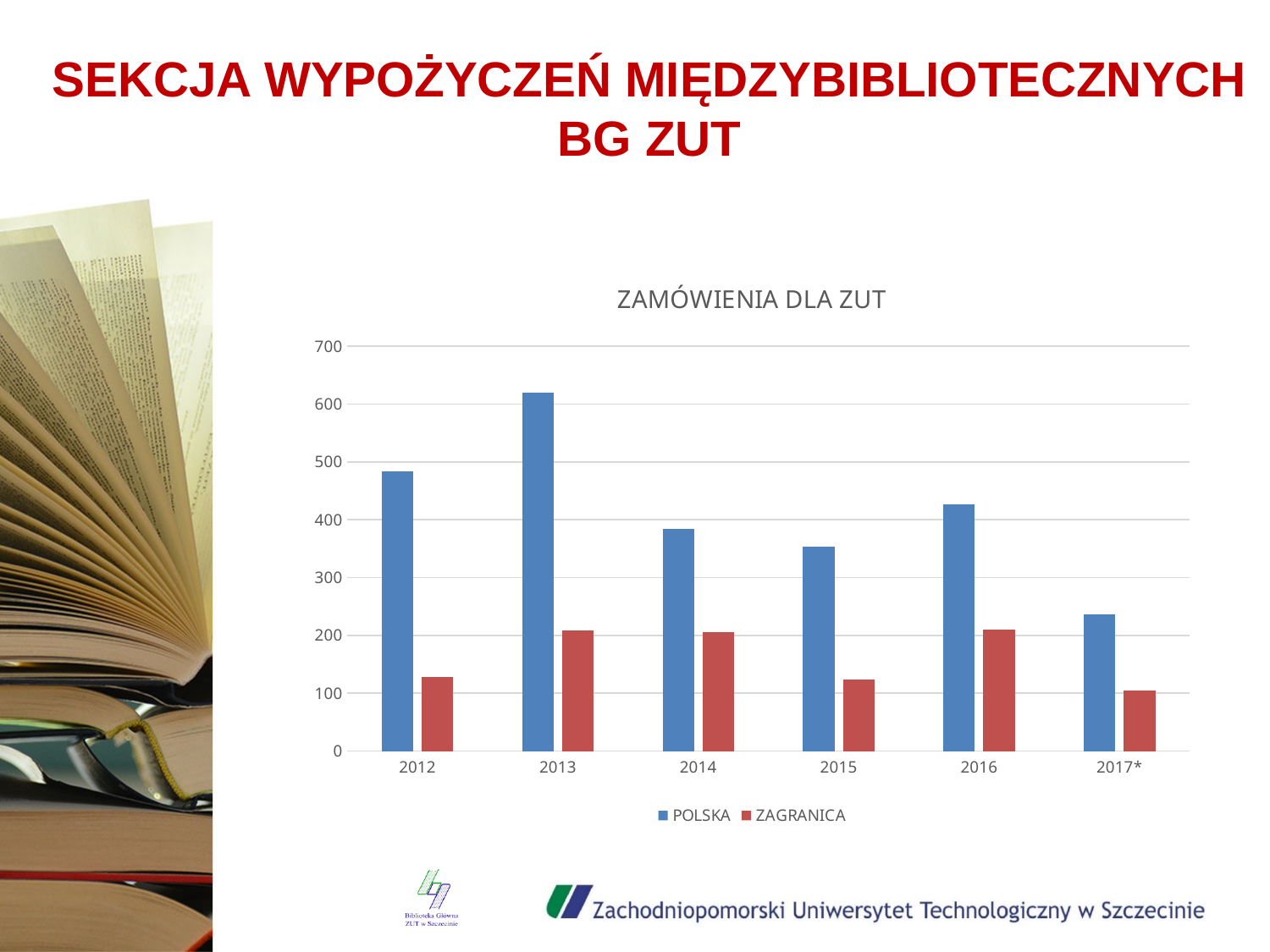
Is the POLSKA value for 2012 greater or less than 500? less In which year is the POLSKA value highest? 2013 Is the ZAGRANICA value for 2012 greater or less than 100? greater What type of chart is shown on the slide? bar chart How many series does the legend list? 2 Which is larger, the POLSKA value for 2012 or for 2016? 2012 Is the POLSKA value for 2013 greater or less than 600? greater What is the title of the chart? ZAMÓWIENIA DLA ZUT In which year is the POLSKA value lowest? 2017* Does the POLSKA value rise or fall from 2013 to 2015? fall How many years are shown on the x axis? 6